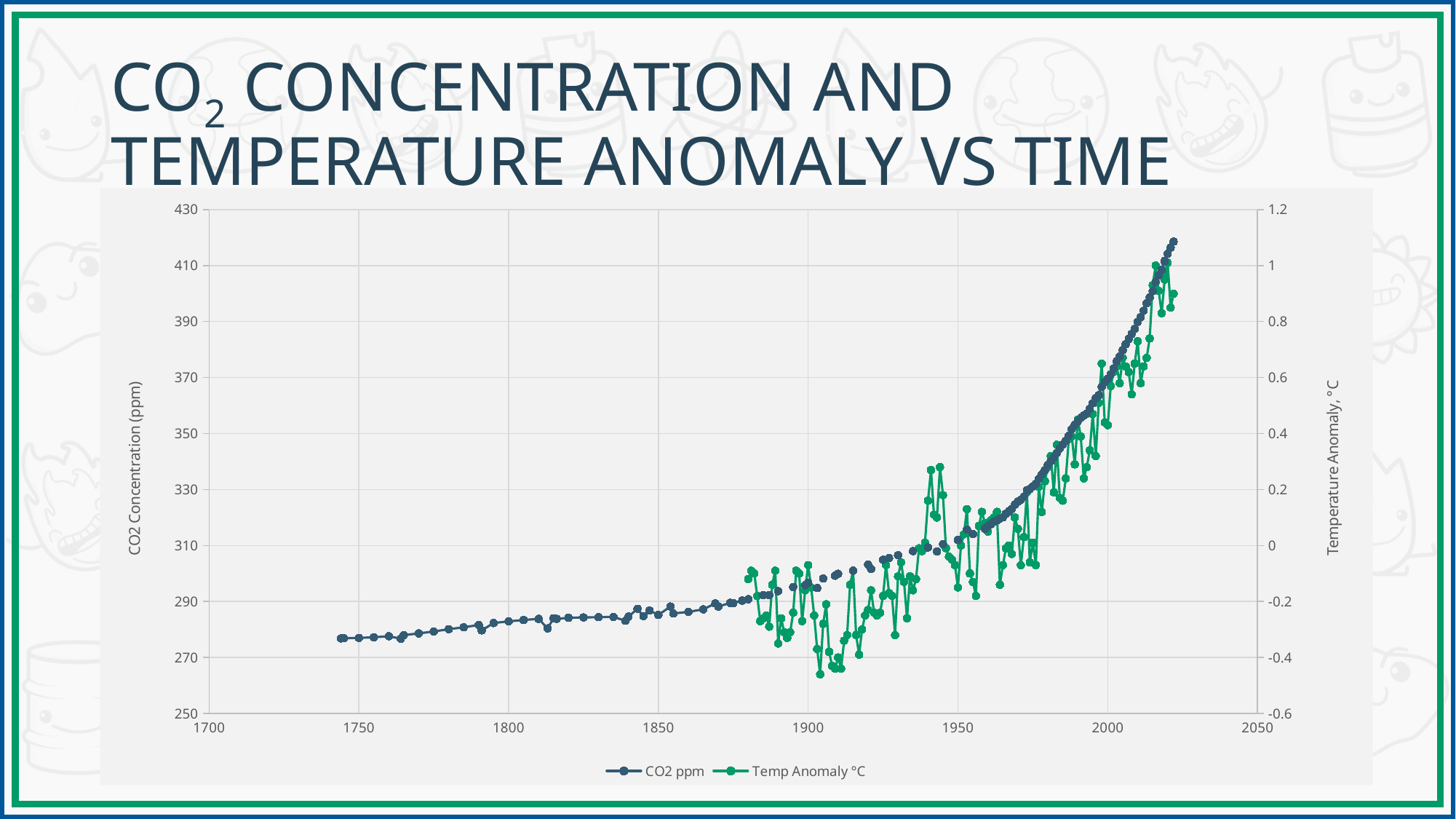
How many series does the legend list? 2 What is the title of the left vertical axis? CO2 Concentration (ppm) Which is larger, the Temp Anomaly °C value around 2010 or around 1910? Around 2010 Does the CO2 ppm series rise or fall as the years increase along the x axis? Rise Is the CO2 ppm value around the year 1750 greater or less than 290? less Is the Temp Anomaly °C value around the year 1910 greater or less than -0.2? less Is the CO2 ppm value around the year 1900 greater or less than 310? less What are the two series named in the legend? CO2 ppm and Temp Anomaly °C What kind of chart is shown on the slide? Line chart Which is larger, the CO2 ppm value around 2000 or the CO2 ppm value around 1900? Around 2000